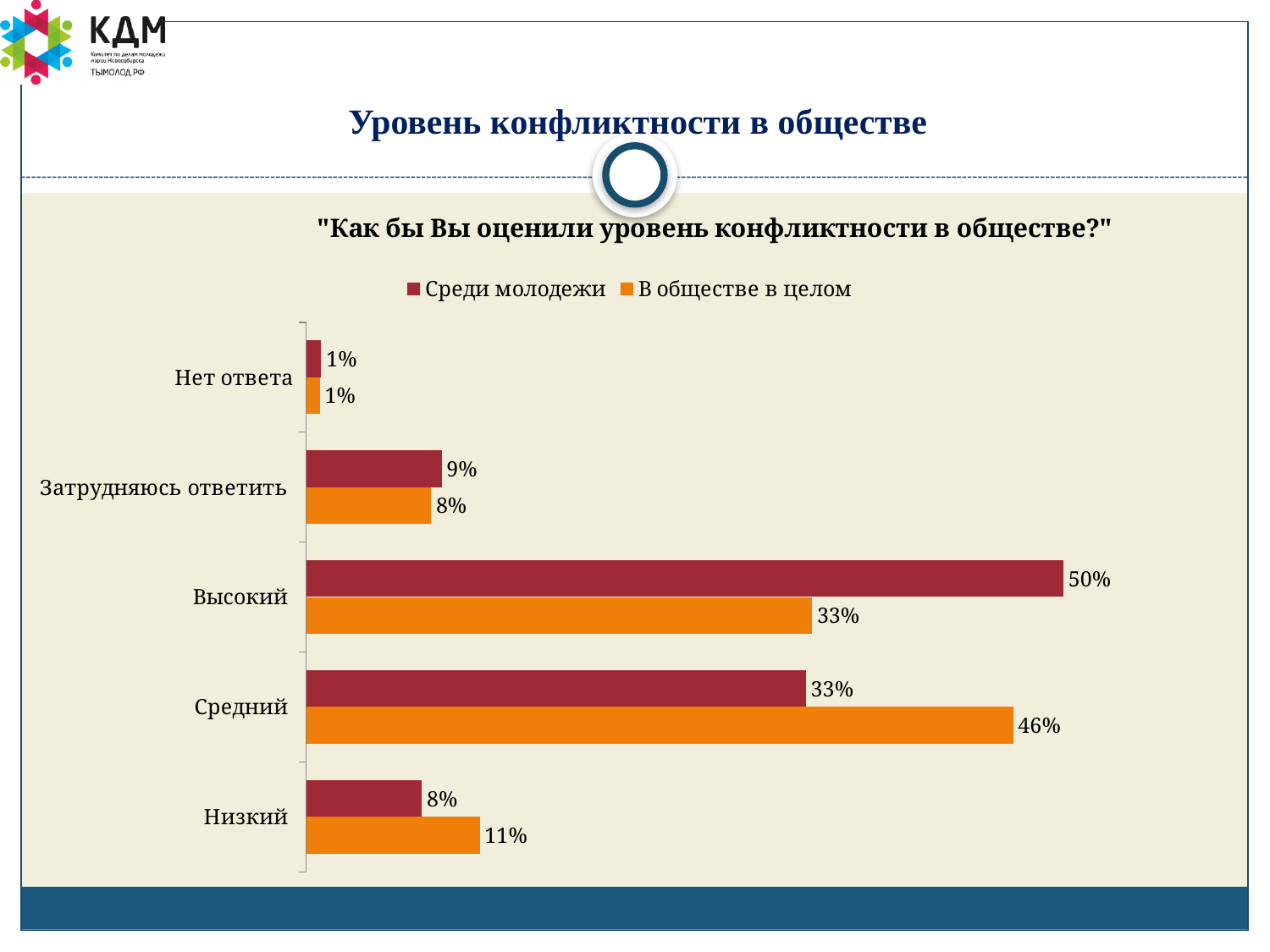
Which category has the highest value in the "Среди молодежи" series? Высокий For "Средний", which series has the larger value: "Среди молодежи" or "В обществе в целом"? В обществе в целом What is the value for "Средний" in the "В обществе в целом" series? 46% What is the value for "Высокий" in the "Среди молодежи" series? 50% What is the value for "Низкий" in the "В обществе в целом" series? 11% What kind of chart is shown on the slide? Bar chart How many series does the legend list? 2 Which category has the lowest value in the "Среди молодежи" series? Нет ответа Which category has the highest value in the "В обществе в целом" series? Средний What is the difference between the "Среди молодежи" and "В обществе в целом" values for "Высокий"? 17% What is the value for "Затрудняюсь ответить" in the "Среди молодежи" series? 9% How many categories are shown on the chart? 5